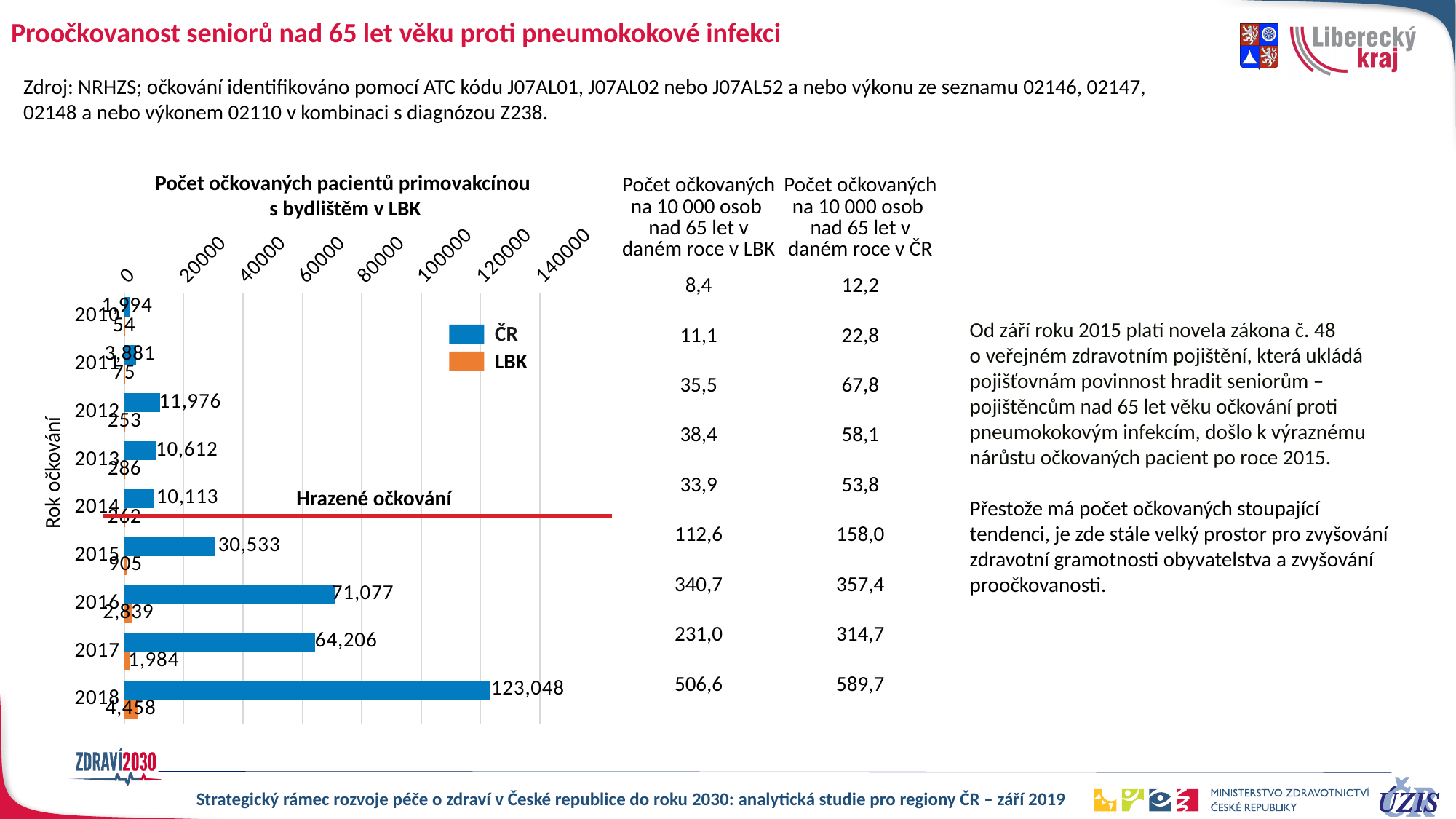
What is the ČR value for 2018? 123,048 What is the difference between the ČR values for 2016 and 2017? 6,871 What is the LBK value for 2017? 1,984 What are the two series named in the chart legend? ČR and LBK Is the ČR value for 2016 greater or less than 60000? greater What kind of chart is shown on the slide? bar chart How many years are shown on the chart's vertical axis? 9 Which year has the lowest LBK value? 2010 How many series does the chart legend list? 2 What is the LBK value for 2016? 2,839 Which year has the highest ČR value? 2018 What is the ČR value for 2015? 30,533